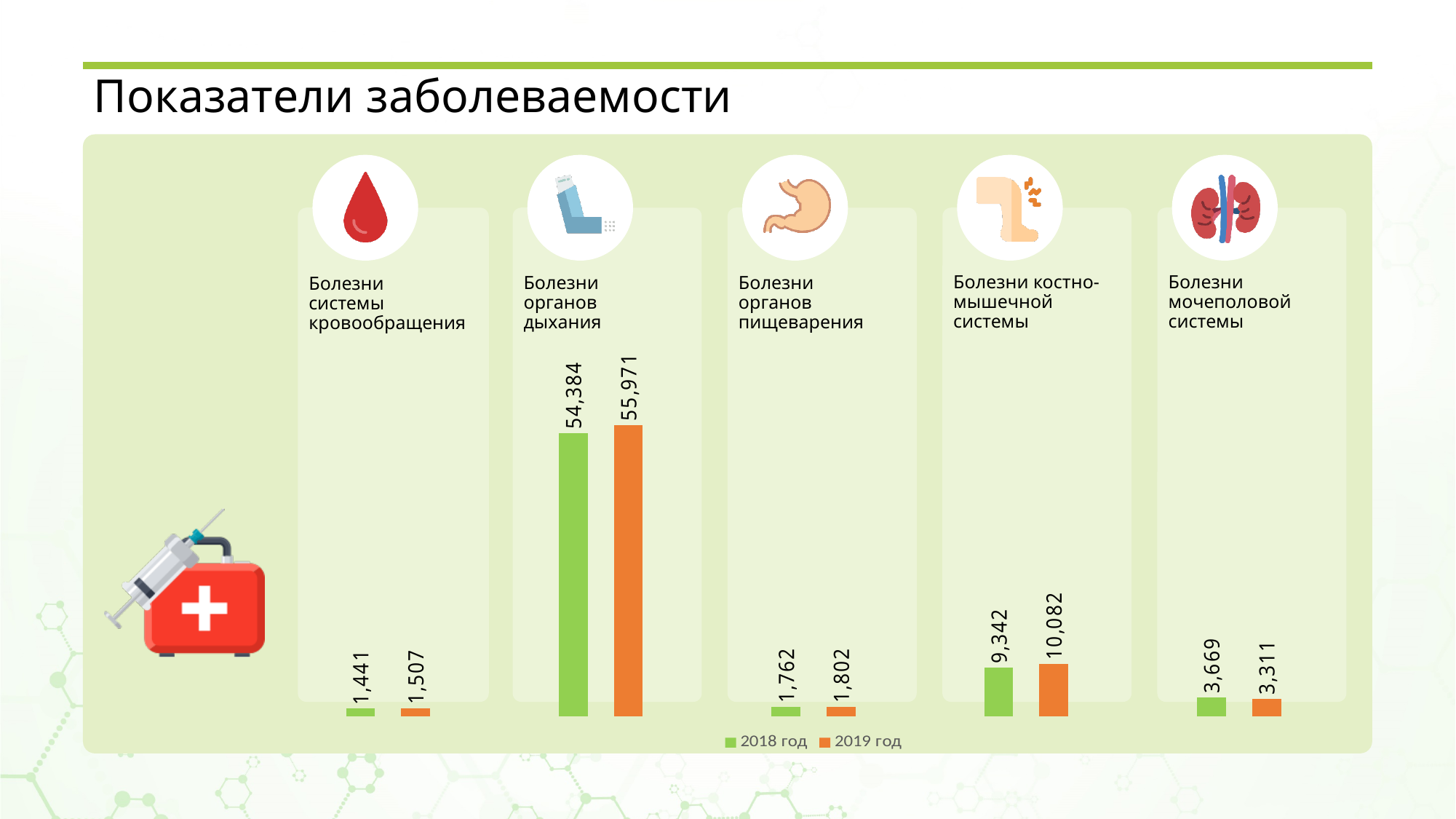
Which category has the lowest value in 2018 год? Болезни системы кровообращения What is the difference between the 2019 год and 2018 год values for Болезни органов дыхания? 1,587 What is the difference between the 2018 год and 2019 год values for Болезни мочеполовой системы? 358 Which category has the highest value in 2019 год? Болезни органов дыхания What is the value for Болезни органов дыхания in 2018 год? 54,384 How many disease categories are shown in the chart? 5 For Болезни мочеполовой системы, which year has the larger value, 2018 год or 2019 год? 2018 год What kind of chart is shown on the slide? Bar chart What is the value for Болезни костно-мышечной системы in 2019 год? 10,082 What is the value for Болезни системы кровообращения in 2019 год? 1,507 What is the value for Болезни мочеполовой системы in 2018 год? 3,669 How many series does the legend list? 2